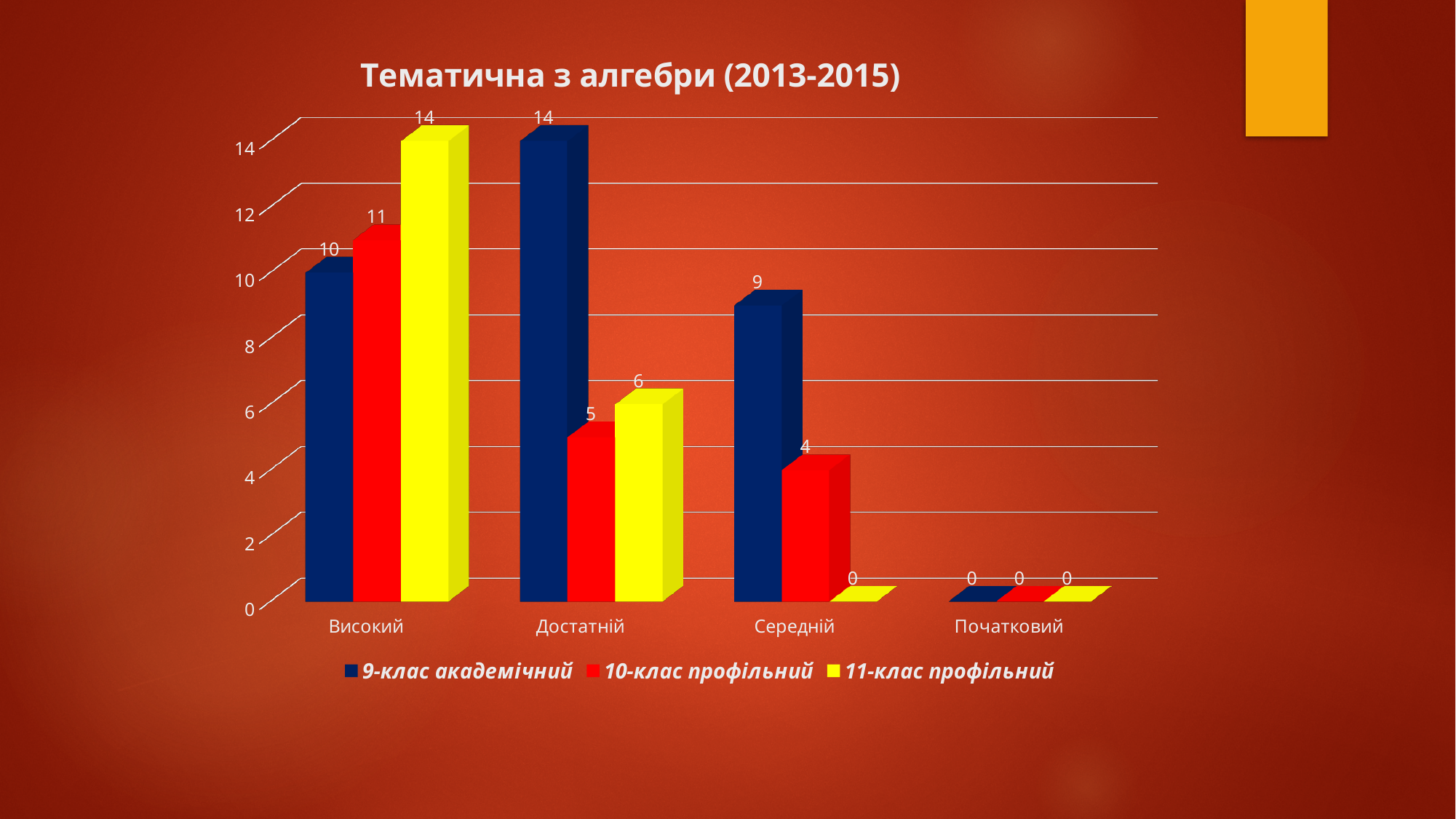
How many series does the legend list? 3 Do the values for 11-клас профільний rise or fall from Високий to Початковий? Fall What is the difference between the 11-клас профільний and 10-клас профільний values in the Високий category? 3 What is the title of the chart? Тематична з алгебри (2013-2015) What is the value for 11-клас профільний in the Достатній category? 6 Which category has the lowest value for 10-клас профільний? Початковий Which is larger in the Достатній category: 9-клас академічний or 10-клас профільний? 9-клас академічний How many categories are shown on the x axis? 4 What is the value for 9-клас академічний in the Високий category? 10 What kind of chart is shown on the slide? Bar chart Which category has the highest value for 9-клас академічний? Достатній What is the value for 10-клас профільний in the Середній category? 4